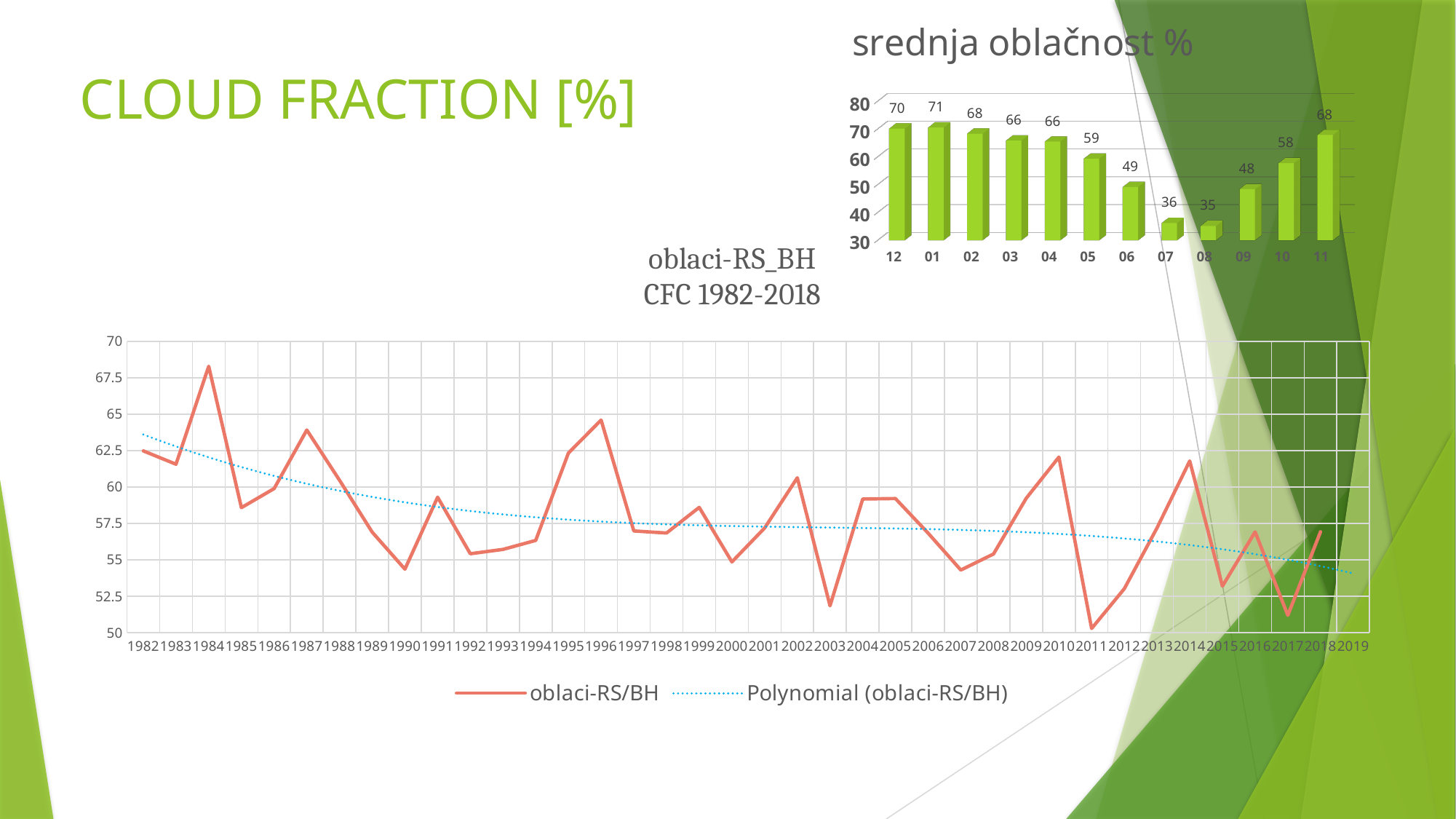
In the 'srednja oblačnost %' chart, which month has the highest value? 01 In the 'srednja oblačnost %' chart, what is the difference between the values for month 12 and month 06? 21 In the 'oblaci-RS_BH CFC 1982-2018' chart, does the dotted Polynomial trendline rise or fall from 1982 to 2018? fall In the 'srednja oblačnost %' chart, what is the value for month 01? 71 How many series does the legend of the 'oblaci-RS_BH CFC 1982-2018' chart list? 2 In the 'oblaci-RS_BH CFC 1982-2018' chart, is the value for 1984 greater or less than 65? greater In the 'srednja oblačnost %' chart, which is larger, the value for month 09 or the value for month 10? 10 In the 'srednja oblačnost %' chart, what is the value for month 07? 36 How many bars are in the 'srednja oblačnost %' chart? 12 In the 'oblaci-RS_BH CFC 1982-2018' chart, is the value for 2011 greater or less than 52.5? less In the 'srednja oblačnost %' chart, which month has the lowest value? 08 What kind of chart is 'srednja oblačnost %'? bar chart